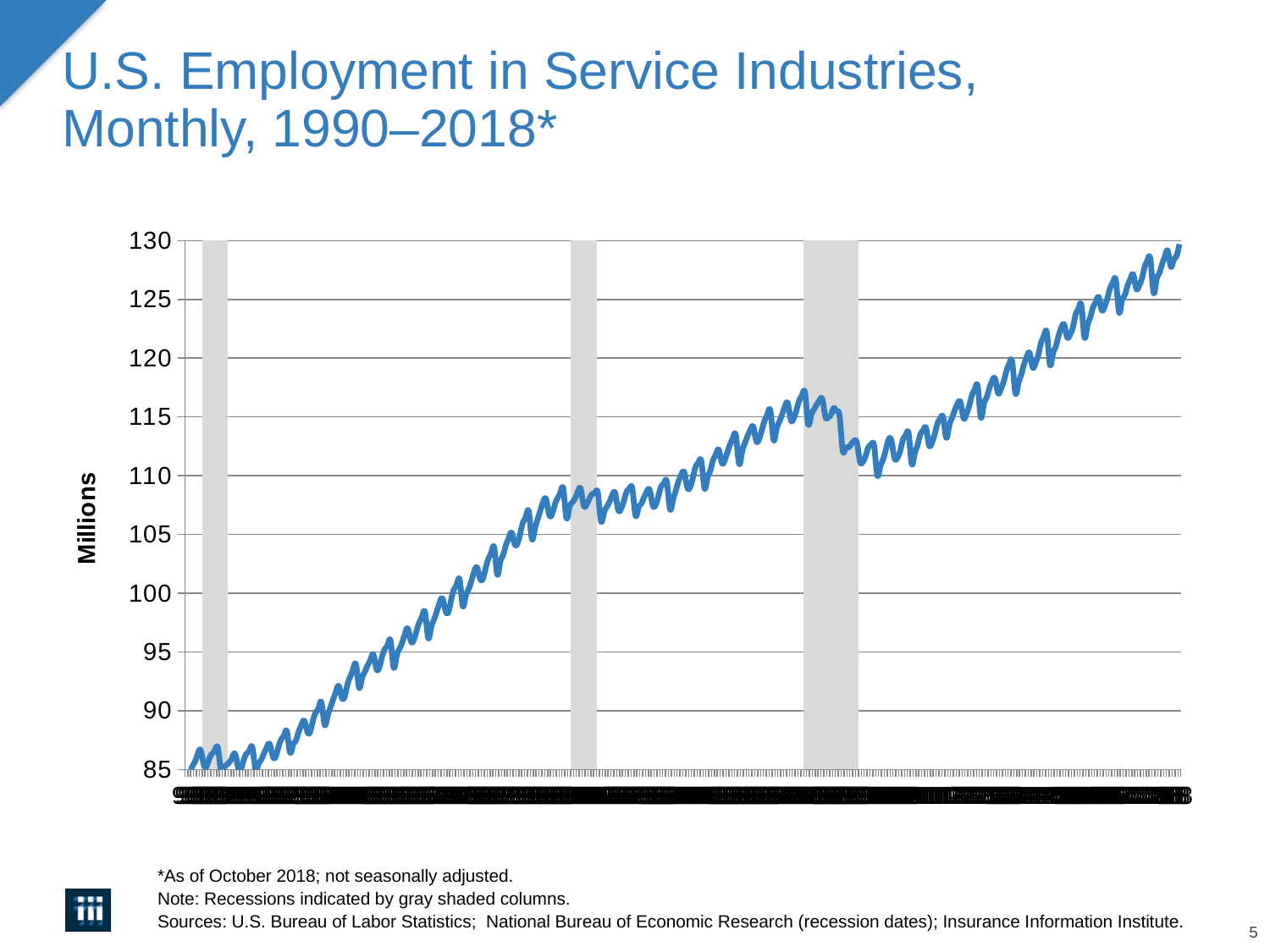
Overall, do the values rise or fall from left to right along the x axis? rise What is the label on the vertical axis of the chart? Millions Is the value at the start of the series (left edge of the chart) greater or less than 90? less What is the title of the chart? U.S. Employment in Service Industries, Monthly, 1990–2018* Is the highest point of the line just before the third gray shaded column greater or less than 115? greater What kind of chart is shown on the slide? line chart Is the value at the end of the series (right edge of the chart) greater or less than 125? greater What is the highest tick value shown on the vertical axis? 130 Which is larger: the value at the start of the series or the value at the end of the series? the value at the end of the series